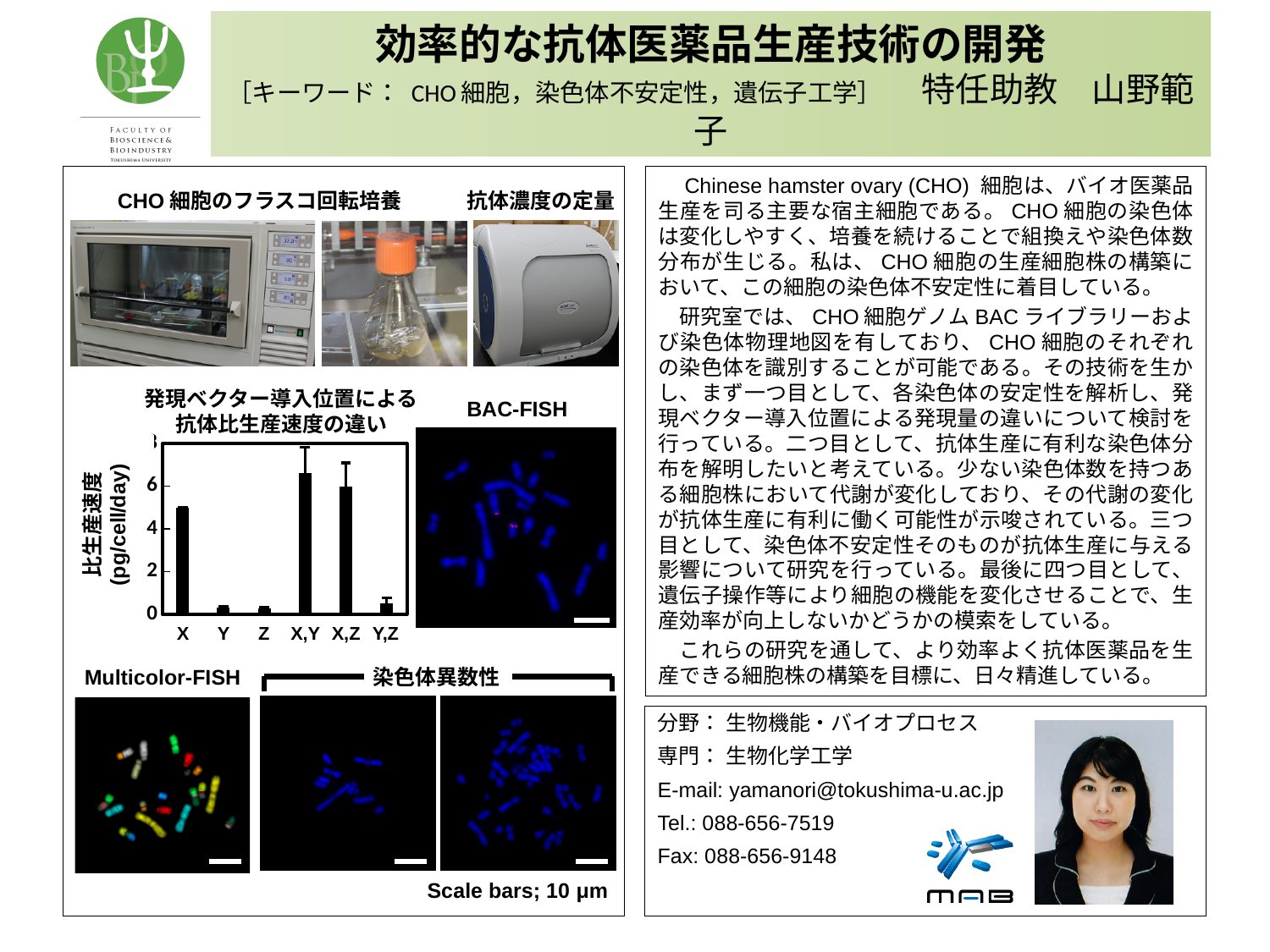
How many categories are shown on the x axis of the bar chart 発現ベクター導入位置による抗体比生産速度の違い? 6 In the bar chart 発現ベクター導入位置による抗体比生産速度の違い, is the value for X,Z greater or less than 4? greater In the bar chart 発現ベクター導入位置による抗体比生産速度の違い, which has the larger value, X,Y or Y,Z? X,Y What kind of chart is the chart titled 発現ベクター導入位置による抗体比生産速度の違い? bar chart What is the y-axis label of the bar chart 発現ベクター導入位置による抗体比生産速度の違い? 比生産速度 (pg/cell/day) In the bar chart 発現ベクター導入位置による抗体比生産速度の違い, is the value for X greater or less than 4? greater In the bar chart 発現ベクター導入位置による抗体比生産速度の違い, which has the larger value, X or Y? X In the bar chart 発現ベクター導入位置による抗体比生産速度の違い, is the value for Y greater or less than 2? less In the bar chart 発現ベクター導入位置による抗体比生産速度の違い, which has the larger value, X,Z or Z? X,Z